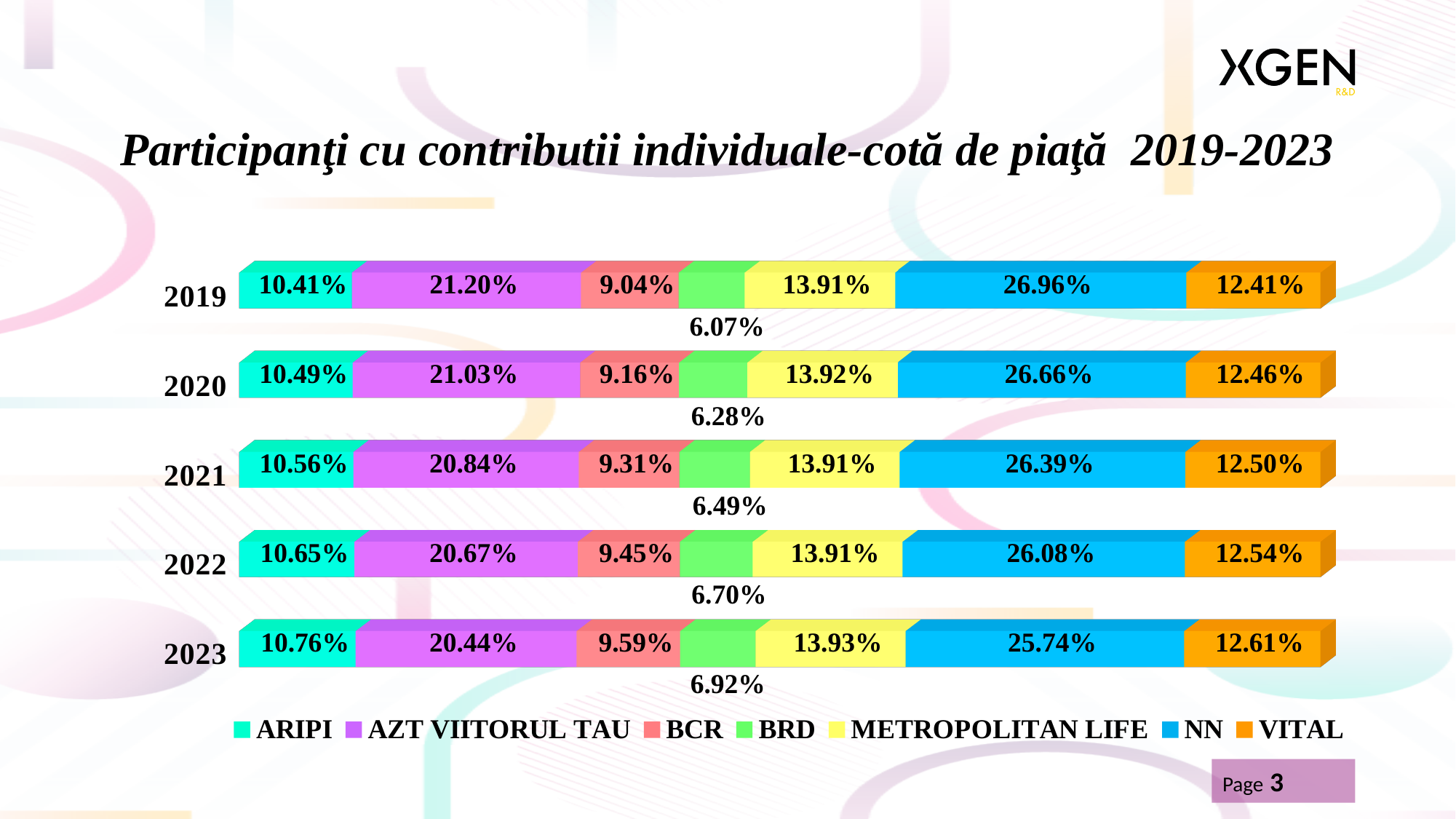
What is the market share of NN in 2019? 26.96% How many years are shown in the chart? 5 What is the market share of VITAL in 2022? 12.54% By how many percentage points did NN's market share fall from 2019 to 2023? 1.22% Does the market share of ARIPI rise or fall from 2019 to 2023? Rise What kind of chart is shown on the slide? Stacked bar chart Which is larger in 2023, the share of BCR or the share of METROPOLITAN LIFE? METROPOLITAN LIFE Which participant has the largest market share in 2023? NN How many participants does the legend list? 7 Which participant has the smallest market share in 2019? BRD What is the market share of BRD in 2021? 6.49% What is the market share of ARIPI in 2023? 10.76%